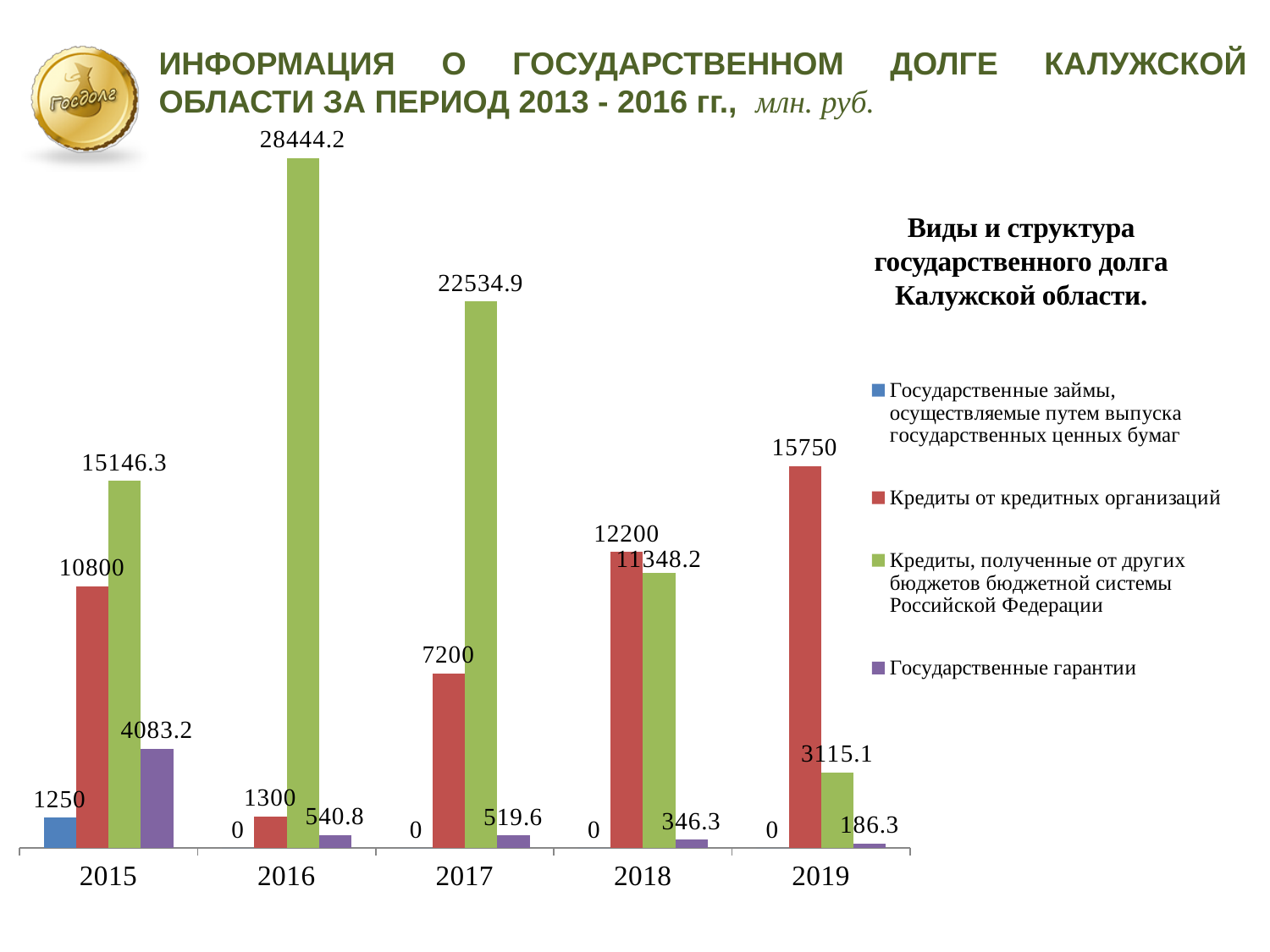
What is the value of 'Кредиты, полученные от других бюджетов бюджетной системы Российской Федерации' in 2016? 28444.2 In 2018, which is larger: 'Кредиты от кредитных организаций' or 'Кредиты, полученные от других бюджетов бюджетной системы Российской Федерации'? Кредиты от кредитных организаций In which year is the value of 'Государственные гарантии' the lowest? 2019 Does the value of 'Государственные гарантии' rise or fall from 2015 to 2019? Fall What is the value of 'Государственные займы, осуществляемые путем выпуска государственных ценных бумаг' in 2015? 1250 In which year is the value of 'Кредиты, полученные от других бюджетов бюджетной системы Российской Федерации' the highest? 2016 What is the value of 'Государственные гарантии' in 2015? 4083.2 How many series does the legend list? 4 What is the difference between 'Кредиты от кредитных организаций' in 2019 and in 2018? 3550 What type of chart is shown on the slide? Bar chart What is the value of 'Кредиты от кредитных организаций' in 2019? 15750 How many years are shown on the x axis? 5